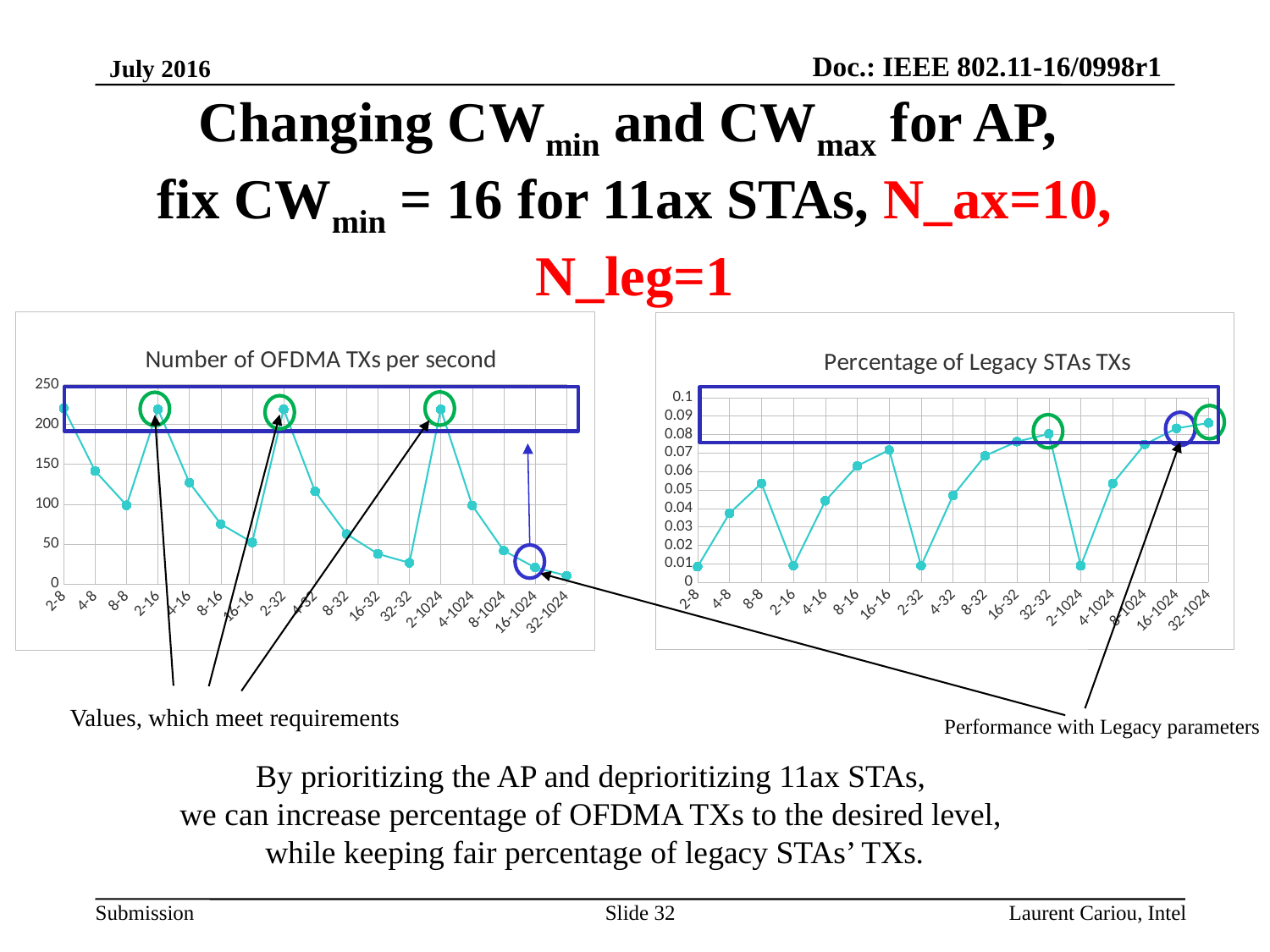
What kind of chart is the 'Number of OFDMA TXs per second' chart? line chart In the 'Number of OFDMA TXs per second' chart, is the value for 2-8 greater or less than 200? greater In the 'Percentage of Legacy STAs TXs' chart, is the value for 2-32 greater or less than 0.02? less In the 'Percentage of Legacy STAs TXs' chart, do the values rise or fall from 2-1024 to 32-1024? rise In the 'Number of OFDMA TXs per second' chart, is the value for 32-32 greater or less than 50? less What is the title of the chart on the right of the slide? Percentage of Legacy STAs TXs How many categories are plotted along the x axis of the 'Number of OFDMA TXs per second' chart? 17 In the 'Number of OFDMA TXs per second' chart, which is larger, the value for 4-8 or the value for 8-8? 4-8 In the 'Percentage of Legacy STAs TXs' chart, which is larger, the value for 16-16 or the value for 4-16? 16-16 In the 'Number of OFDMA TXs per second' chart, which category has the lowest value? 32-1024 In the 'Number of OFDMA TXs per second' chart, do the values rise or fall from 2-32 to 32-32? fall